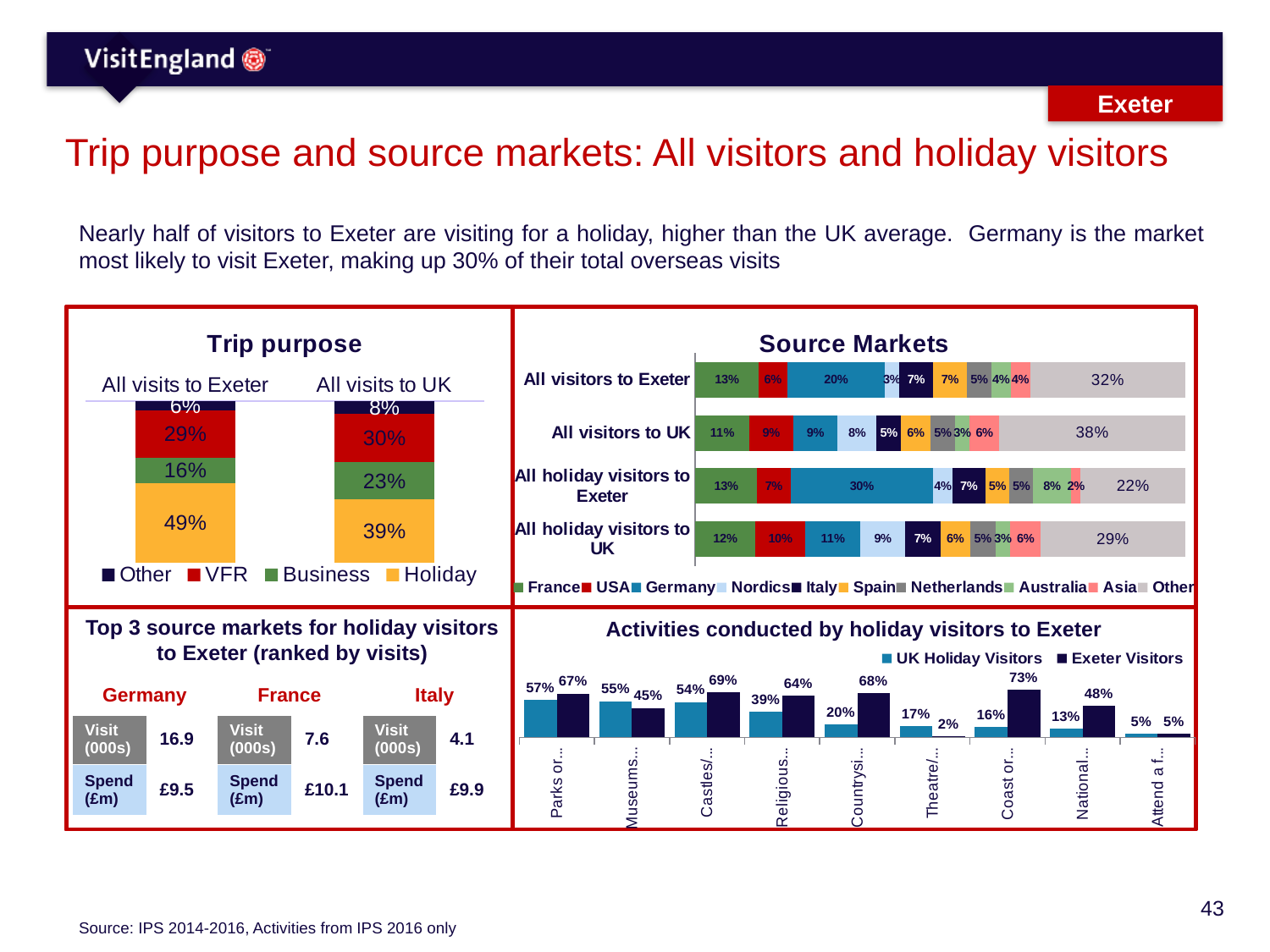
In the Source Markets chart, what is the Other share for All visitors to UK? 38% How many series does the legend of the Trip purpose chart list? 4 In the Trip purpose chart, what percentage of all visits to Exeter are for Holiday? 49% In the Trip purpose chart, what is the difference between the Holiday share for All visits to Exeter and for All visits to UK? 10 percentage points In the Source Markets chart, which category has the largest Germany share? All holiday visitors to Exeter In the Source Markets chart, what is the Germany share for All holiday visitors to Exeter? 30% What kind of chart is the Activities conducted by holiday visitors to Exeter chart? Bar chart In the Trip purpose chart, what percentage of all visits to UK are for Business? 23% In the Activities conducted by holiday visitors to Exeter chart, what is the Exeter Visitors value for Coast or...? 73% How many series does the legend of the Source Markets chart list? 10 In the Activities conducted by holiday visitors to Exeter chart, which activity has the highest UK Holiday Visitors value? Parks or... In the Activities conducted by holiday visitors to Exeter chart, which is larger for Museums..., UK Holiday Visitors or Exeter Visitors? UK Holiday Visitors